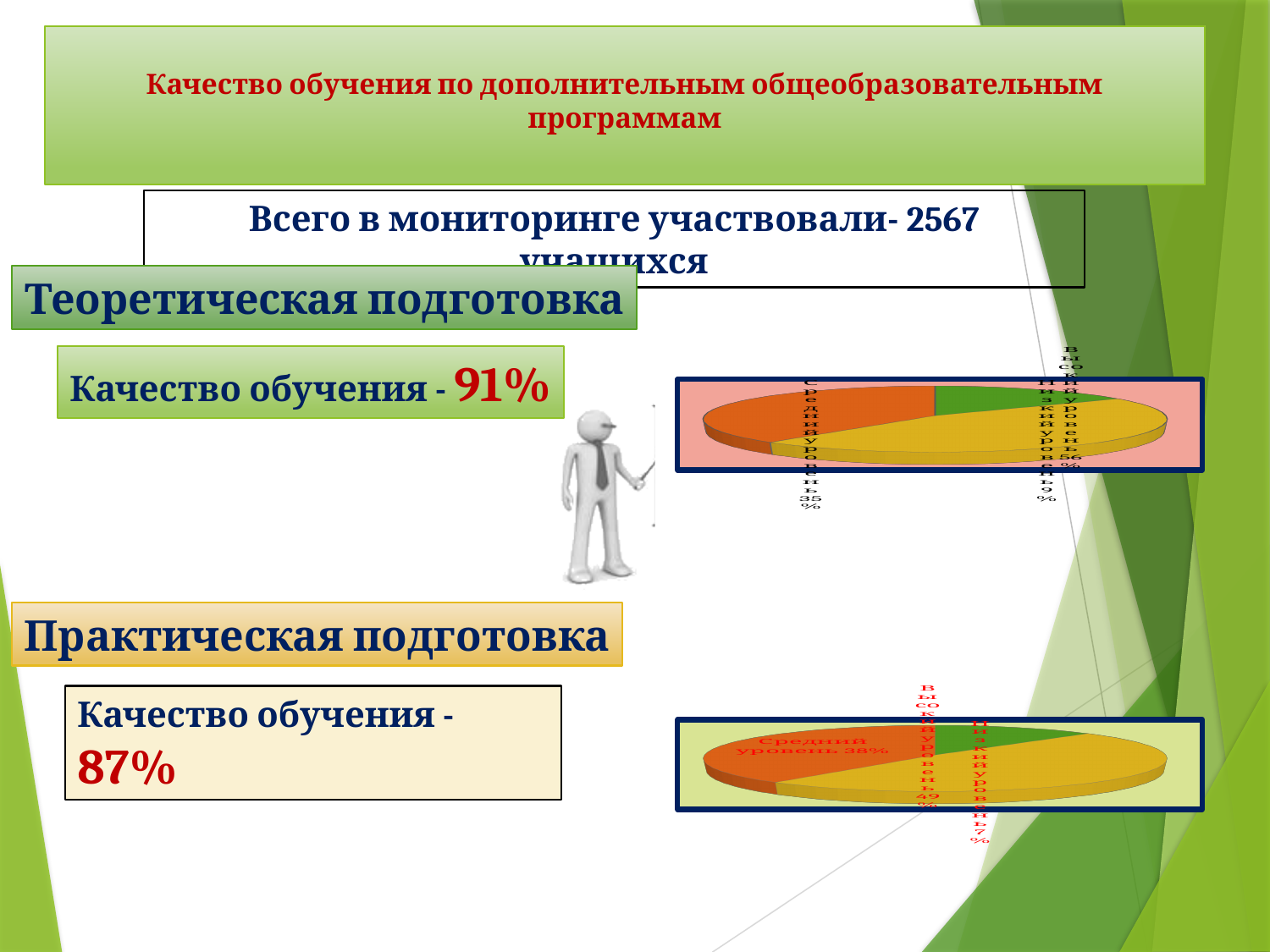
In the bottom pie chart (Практическая подготовка), which level has the largest slice? Высокий уровень In the top pie chart (Теоретическая подготовка), what share is labelled for Средний уровень? 35% In the top pie chart (Теоретическая подготовка), which level has the largest slice? Высокий уровень In the top pie chart (Теоретическая подготовка), what share is labelled for Высокий уровень? 56% How many slices does the top pie chart (Теоретическая подготовка) have? 3 In the top pie chart (Теоретическая подготовка), by how many percentage points does Высокий уровень exceed Средний уровень? 21 percentage points In the bottom pie chart (Практическая подготовка), what share is labelled for Низкий уровень? 7% In the top pie chart (Теоретическая подготовка), which level has the smallest slice? Низкий уровень What kind of chart is used for the Теоретическая подготовка section? Pie chart In the bottom pie chart (Практическая подготовка), what share is labelled for Средний уровень? 38% In the top pie chart (Теоретическая подготовка), what share is labelled for Низкий уровень? 9% In the bottom pie chart (Практическая подготовка), which is larger: Средний уровень or Низкий уровень? Средний уровень